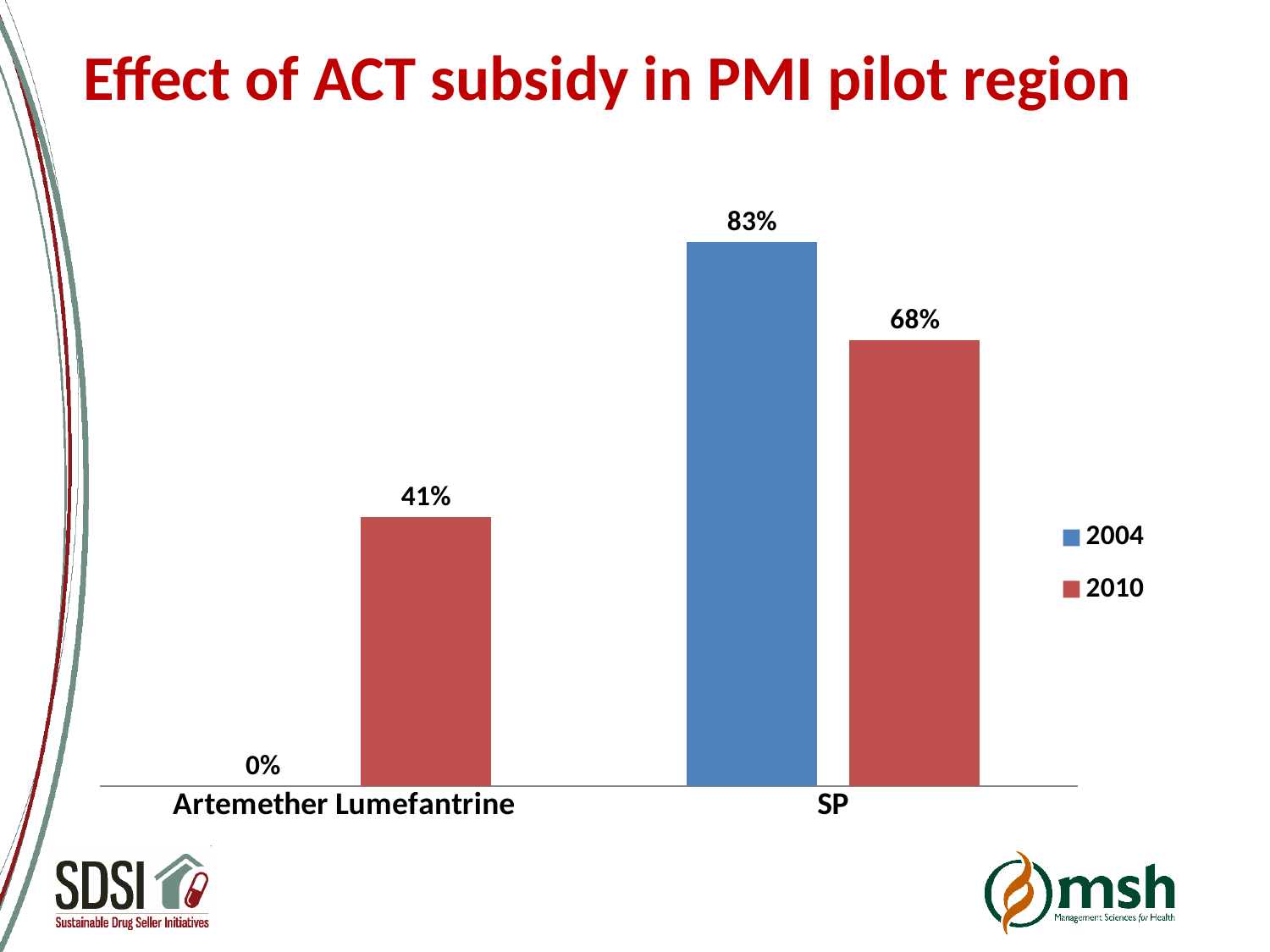
Which bar in the chart has the lowest value? Artemether Lumefantrine in 2004 By how many percentage points did the value for SP fall from 2004 to 2010? 15 What is the difference between the 2010 values for SP and Artemether Lumefantrine? 27 What was the value for SP in 2010? 68% What was the value for Artemether Lumefantrine in 2004? 0% In 2010, which was higher: Artemether Lumefantrine or SP? SP What type of chart is shown on the slide? Bar chart How many categories are shown on the x axis? 2 How many series does the legend list? 2 Which bar in the chart has the highest value? SP in 2004 What was the value for Artemether Lumefantrine in 2010? 41% What was the value for SP in 2004? 83%